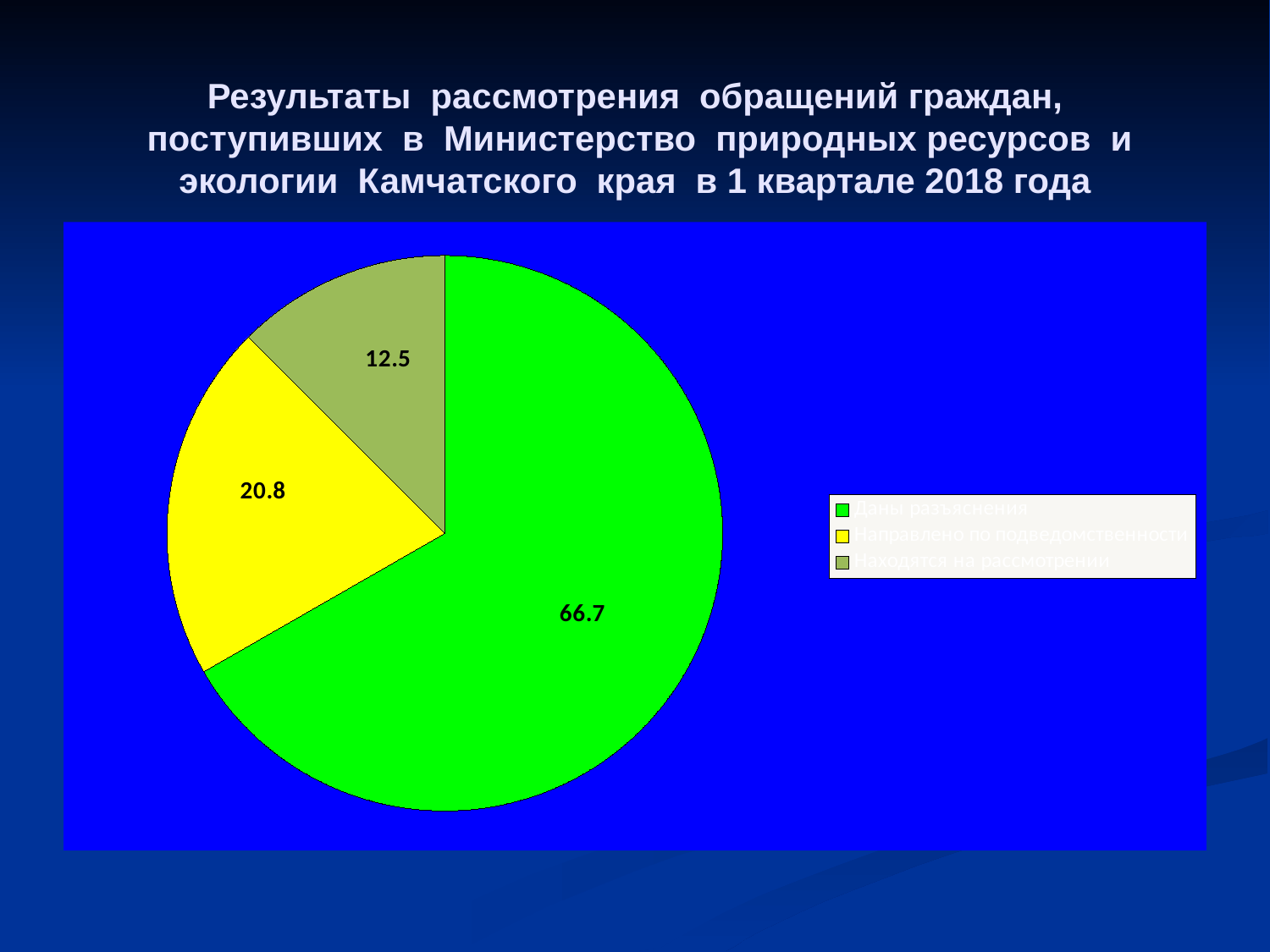
Which category has the largest slice of the pie? Даны разъяснения Which is larger: the slice for "Направлено по подведомственности" or the slice for "Находятся на рассмотрении"? Направлено по подведомственности What is the value of the slice for "Направлено по подведомственности"? 20.8 How many slices does the pie chart have? 3 What is the difference between the values for "Направлено по подведомственности" and "Находятся на рассмотрении"? 8.3 What is the value of the slice for "Даны разъяснения"? 66.7 How many entries does the legend list? 3 What colour is the slice for "Даны разъяснения"? green What is the difference between the values for "Даны разъяснения" and "Направлено по подведомственности"? 45.9 What kind of chart is shown on the slide? pie chart What is the value of the slice for "Находятся на рассмотрении"? 12.5 Which category has the smallest slice of the pie? Находятся на рассмотрении